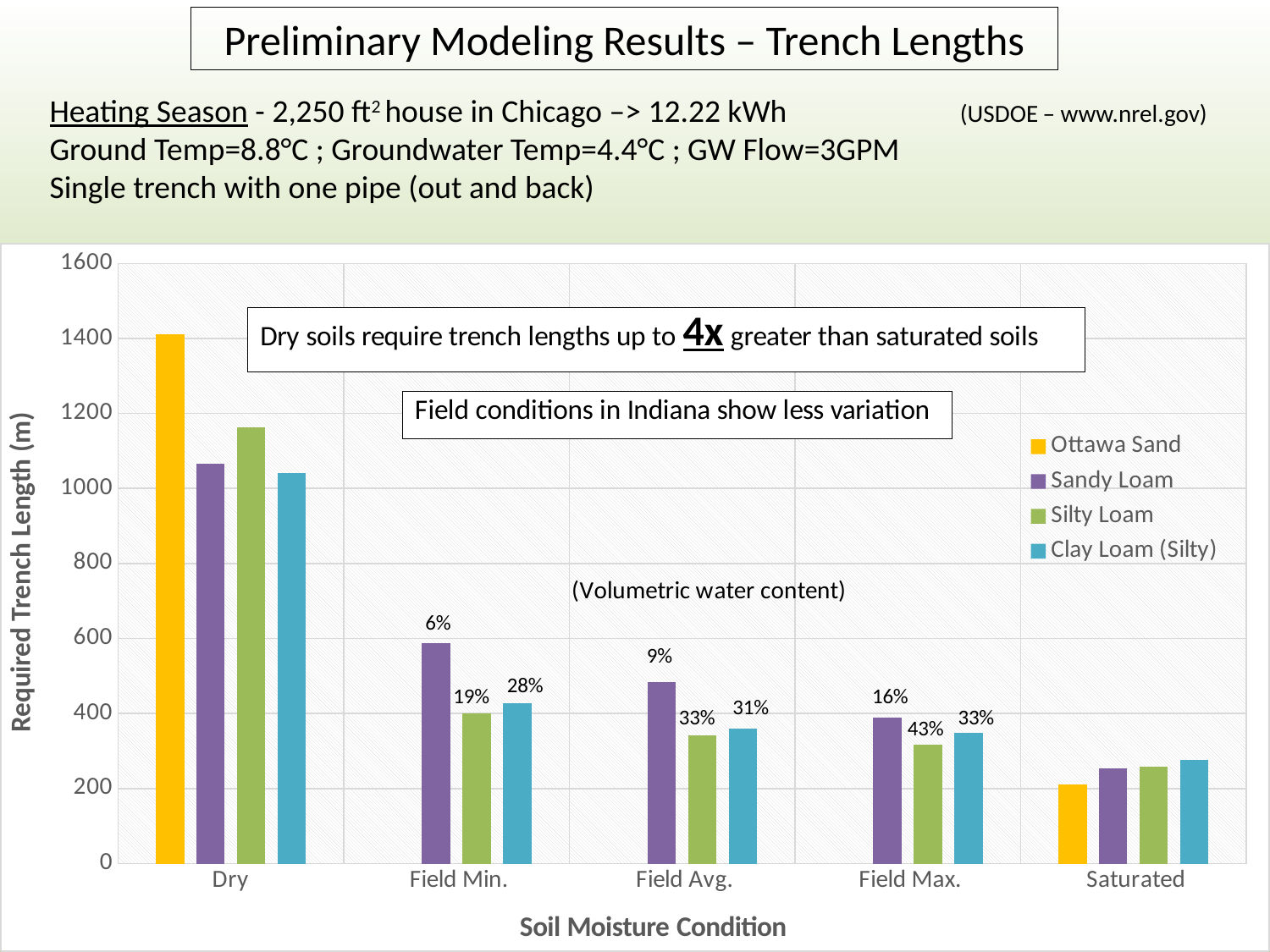
What volumetric water content label is printed above the Sandy Loam bar for Field Avg.? 9% Is the value for Sandy Loam in the Field Min. condition greater or less than 400? greater Is the value for Ottawa Sand in the Dry condition greater or less than 1200? greater How many series does the legend list? 4 In the Field Min. condition, which is larger: Sandy Loam or Silty Loam? Sandy Loam Which soil moisture condition has the highest required trench length for Ottawa Sand? Dry How many soil moisture conditions are shown on the x axis? 5 What kind of chart is shown on the slide? bar chart Is the value for Ottawa Sand in the Saturated condition greater or less than 400? less Do the Sandy Loam bars rise or fall from Dry to Saturated along the x axis? fall In the Dry condition, which is larger: Ottawa Sand or Sandy Loam? Ottawa Sand Which series has the lowest bar in the Saturated condition? Ottawa Sand